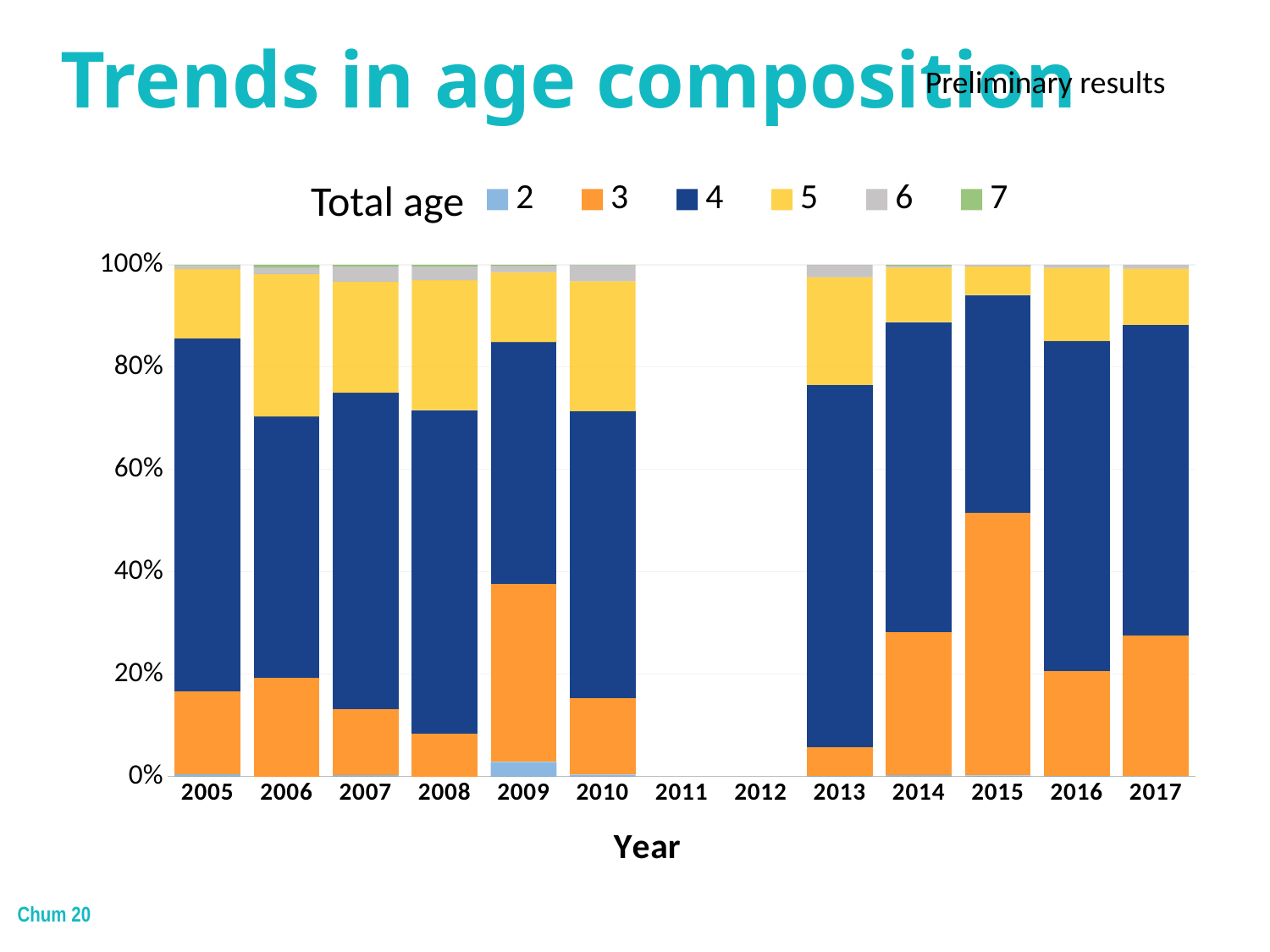
How many year categories are labelled on the x axis of the chart? 13 What is the title of the chart? Total age How many series does the legend of the 'Total age' chart list? 6 Which year has the largest share of age 3 (orange segment)? 2015 In 2015, is the combined share of ages 3 and 4 greater or less than 90%? greater Which year has the larger share of age 3: 2014 or 2016? 2014 Is the share of age 3 in 2015 greater or less than 40%? greater Which year has the larger share of age 3: 2009 or 2010? 2009 Is the share of age 2 in 2009 greater or less than 20%? less Which two years on the x axis have no bars plotted? 2011 and 2012 What kind of chart is shown on the slide? Stacked bar chart